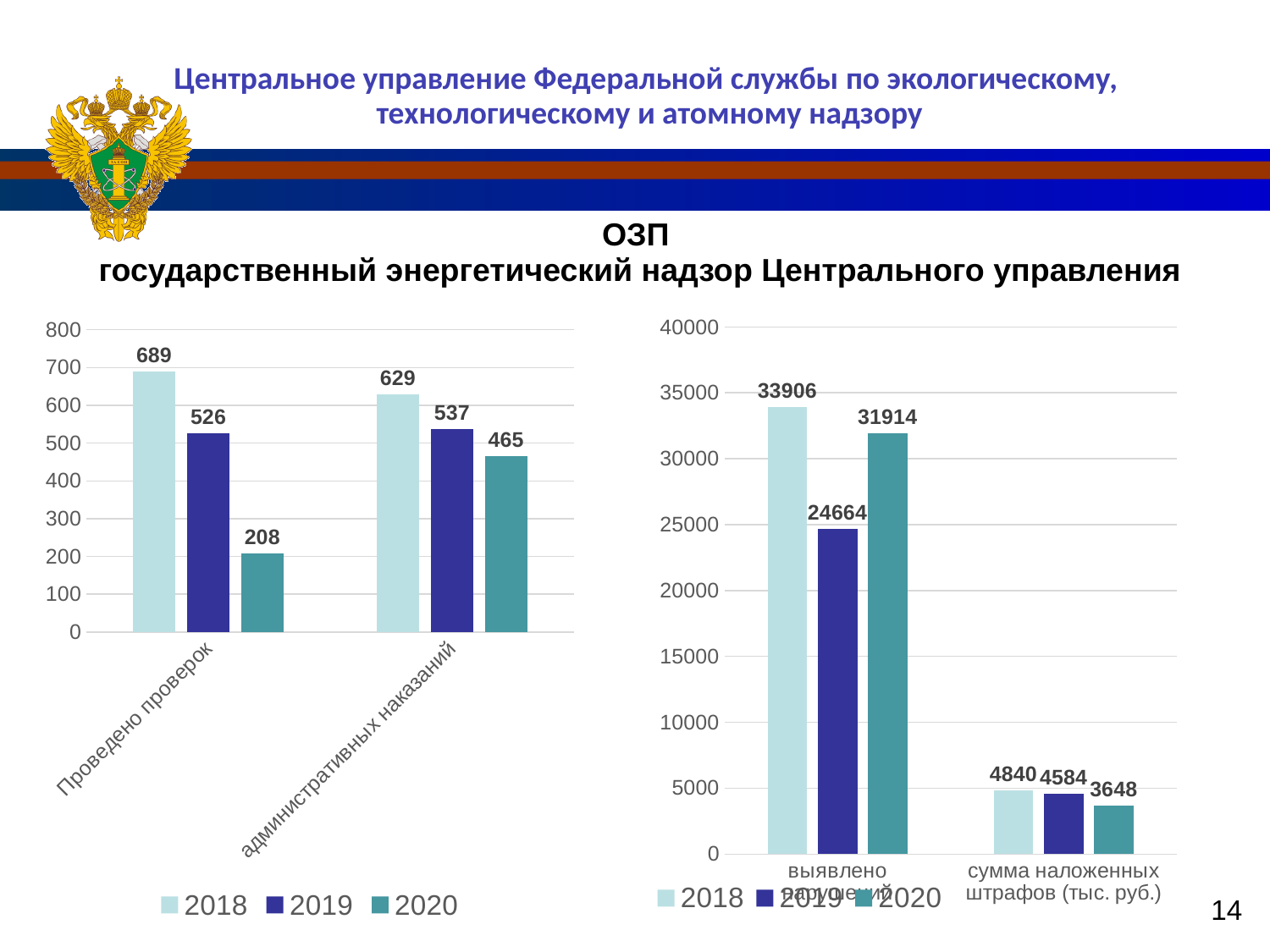
In the right chart, is the 2018 value for 'выявлено нарушений' larger or smaller than the 2020 value? larger In the left chart, what is the value for 2020 in the 'административных наказаний' category? 465 In the left chart, do the values for 'Проведено проверок' rise or fall from 2018 to 2020? fall In the right chart, what is the value for 2019 in the 'выявлено нарушений' category? 24664 In the left chart, which year has the lowest value in the 'Проведено проверок' category? 2020 What kind of chart is the right chart? bar chart In the right chart, which year has the highest value in the 'выявлено нарушений' category? 2018 In the right chart, what is the value for 2020 in the 'сумма наложенных штрафов (тыс. руб.)' category? 3648 In the left chart, how many series does the legend list? 3 In the left chart, what is the value for 2018 in the 'Проведено проверок' category? 689 In the right chart, what is the difference between the 2018 and 2020 values in the 'сумма наложенных штрафов (тыс. руб.)' category? 1192 In the left chart, what is the difference between the 2018 and 2019 values in the 'Проведено проверок' category? 163